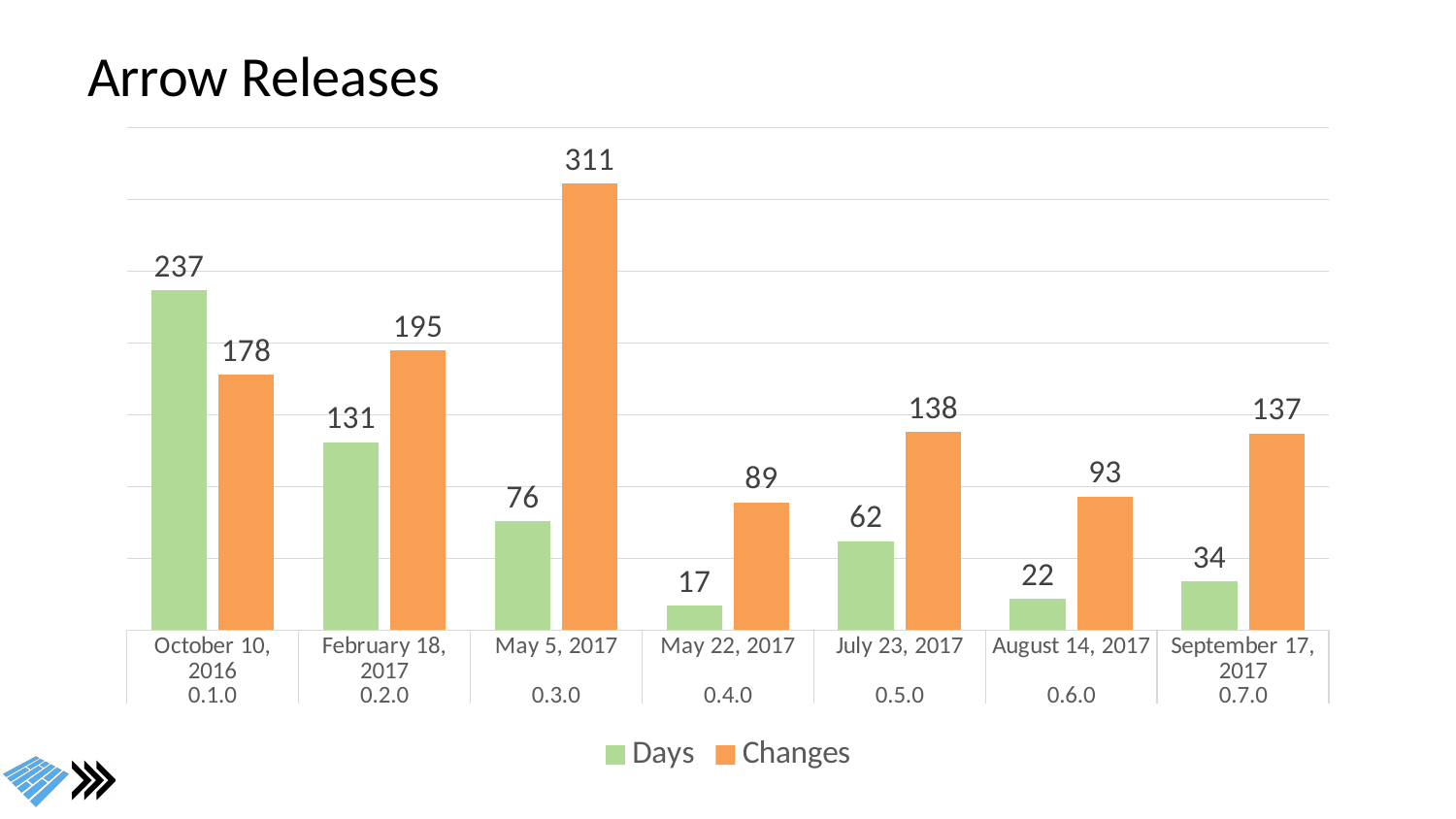
What kind of chart is shown on the slide? Bar chart What is the difference between the Changes and Days values for the 0.1.0 release (October 10, 2016)? 59 Which release has the lowest Days value? 0.4.0 (May 22, 2017) How many series does the legend list? 2 What is the title of the chart? Arrow Releases What is the Days value for the 0.3.0 release (May 5, 2017)? 76 What is the Days value for the 0.7.0 release (September 17, 2017)? 34 Which release has the highest Changes value? 0.3.0 (May 5, 2017) What is the Changes value for the 0.5.0 release (July 23, 2017)? 138 Which is larger for the 0.2.0 release (February 18, 2017): Days or Changes? Changes How many releases are shown on the x axis? 7 Which colour represents the Changes series in the legend? Orange